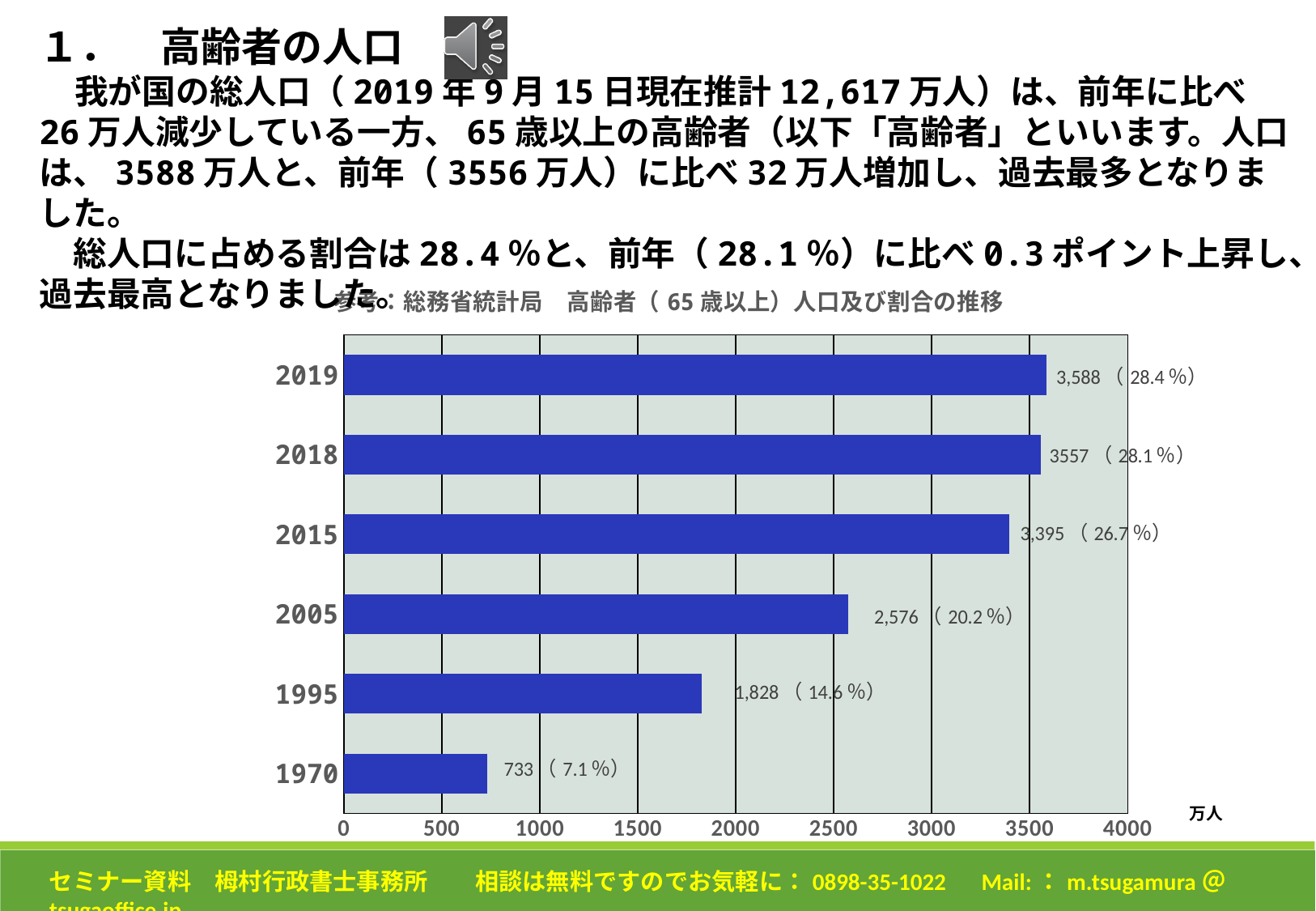
What percentage is shown in parentheses for 2005? 20.2％ What is the difference between the values for 2005 and 1995? 748 What is the difference between the values for 2019 and 1970? 2,855 Which year has the lowest value? 1970 What type of chart is shown on the slide? bar chart Which year has the highest value? 2019 What is the value shown for 1970? 733 How many years (bars) are shown in the chart? 6 What is the value shown for 2019? 3,588 What is the value shown for 1995? 1,828 Which is larger, the value for 2015 or the value for 2005? 2015 What unit label is shown next to the horizontal axis? 万人